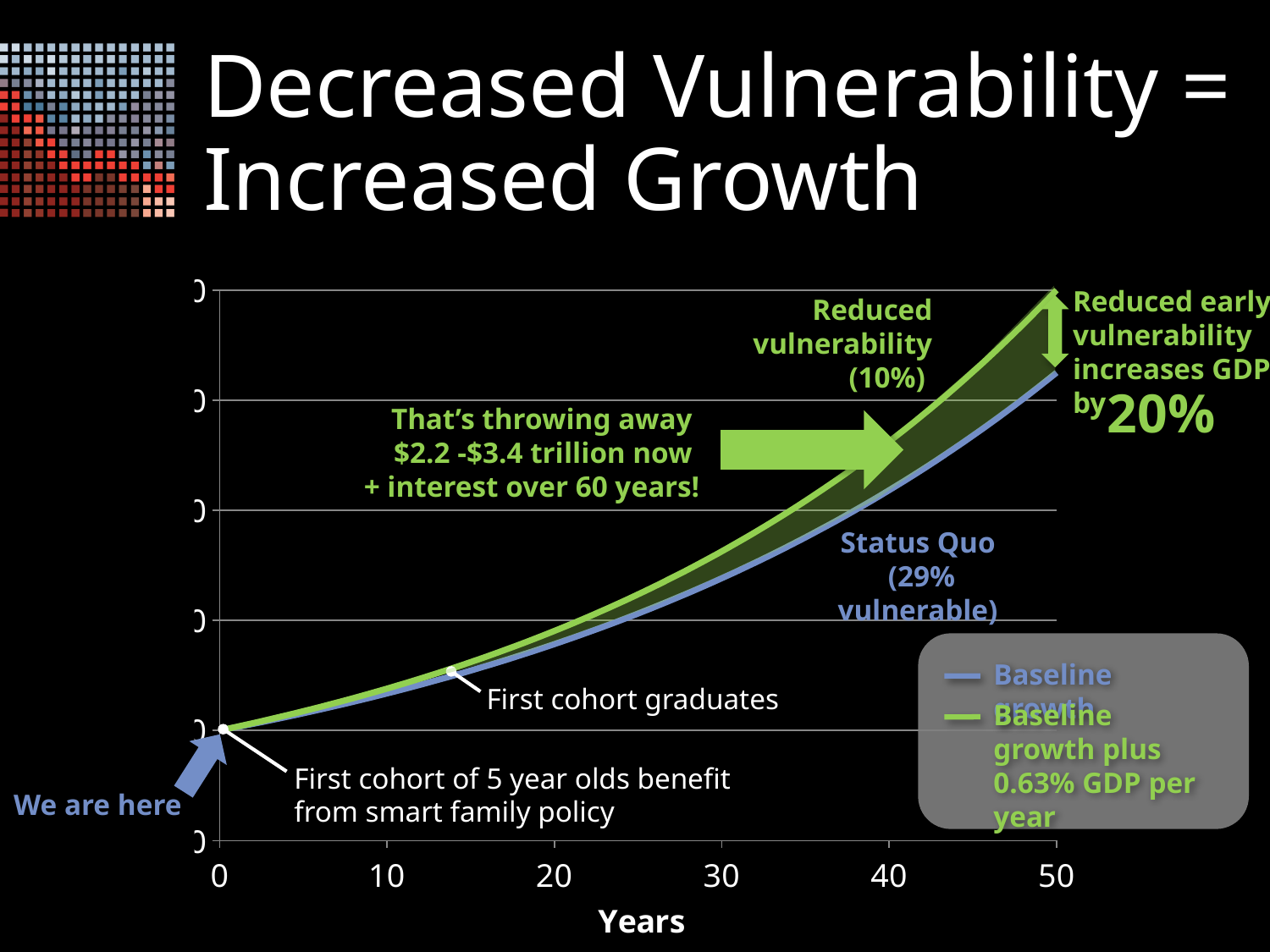
How many series does the chart's legend list? 2 According to the chart annotation, what percentage is vulnerable under the Status Quo? 29% Which series is drawn in blue in the chart? Baseline growth Which series is drawn in green in the chart? Baseline growth plus 0.63% GDP per year What is the label on the x axis of the chart? Years What kind of chart is shown on the slide? Line chart Do the plotted lines rise or fall as the years increase along the x axis? Rise At which year on the x axis do the two series start from the same point? 0 According to the annotation on the chart, by what percentage does reduced early vulnerability increase GDP? 20% At year 50, which series is higher: Baseline growth or Baseline growth plus 0.63% GDP per year? Baseline growth plus 0.63% GDP per year According to the chart annotation, what is the vulnerability percentage in the reduced vulnerability scenario? 10%